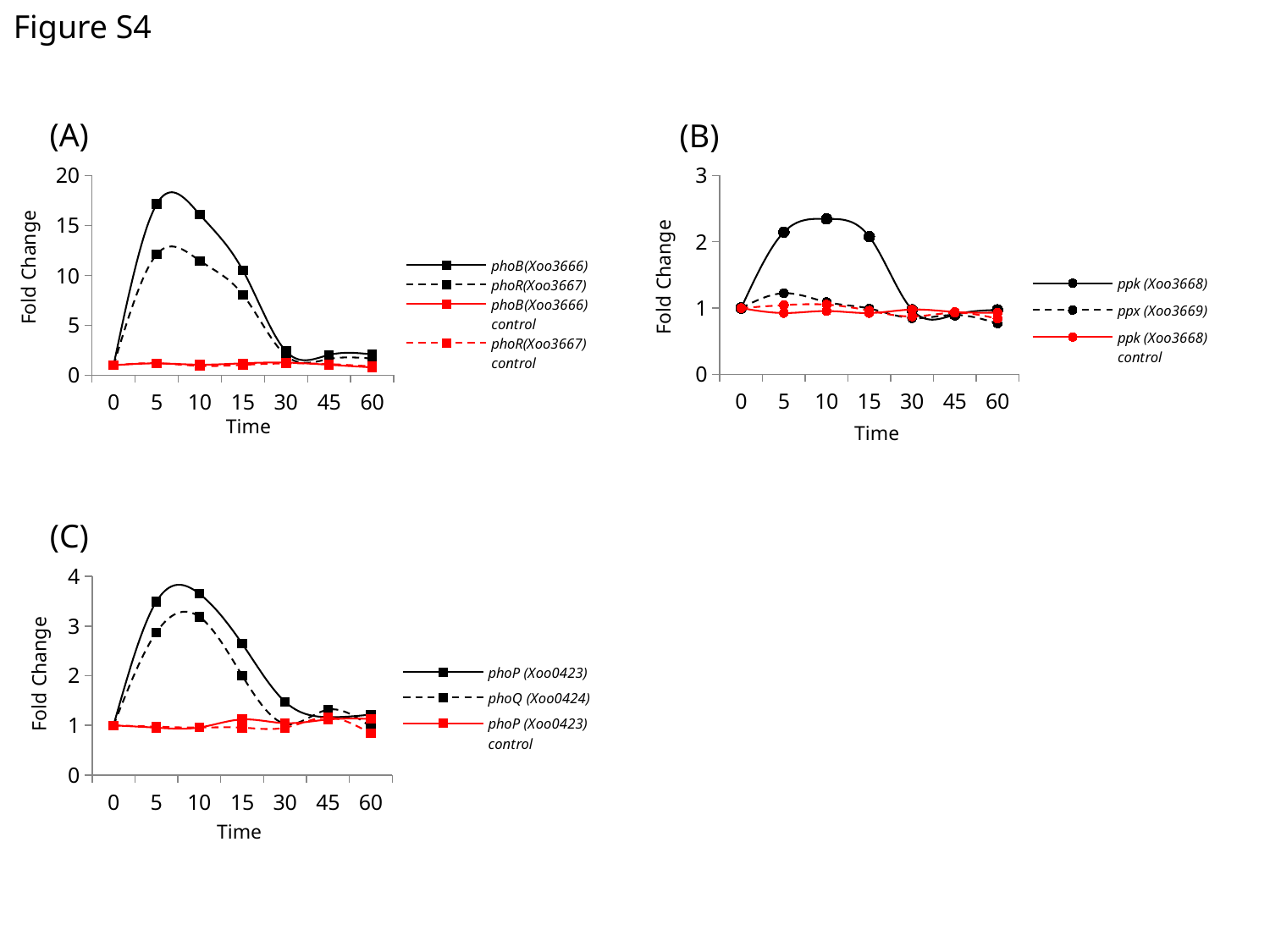
In chart (A), is the value of phoR(Xoo3667) at time 5 greater or less than 10? greater In chart (C), at time 15, which series has the larger value: phoP (Xoo0423) or phoQ (Xoo0424)? phoP (Xoo0423) In chart (A), does the phoB(Xoo3666) series rise or fall between time 10 and time 30? fall What kind of chart is chart (A)? line chart How many time points are plotted along the x axis of chart (C)? 7 In chart (C), is the value of phoP (Xoo0423) at time 10 greater or less than 3? greater In chart (B), at which time point does ppk (Xoo3668) reach its highest value? 10 In chart (A), is the value of phoB(Xoo3666) at time 5 greater or less than 15? greater How many series does the legend of chart (B) list? 3 How many series does the legend of chart (A) list? 4 In chart (A), at which time point does phoB(Xoo3666) reach its highest value? 5